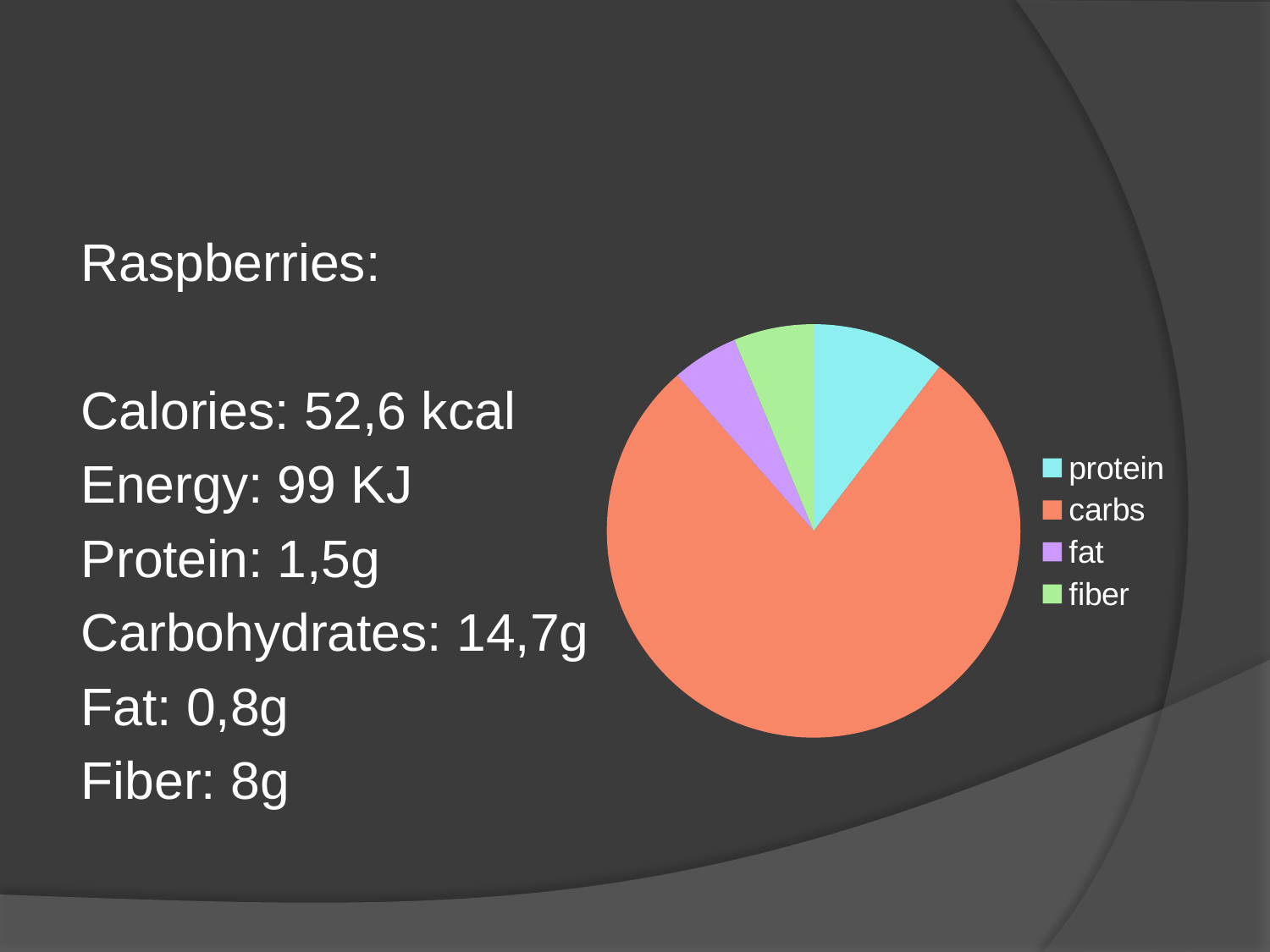
Which category has the largest slice in the pie chart? carbs What colour is the carbs slice in the pie chart? orange How many slices does the pie chart have? 4 Which slice is larger in the pie chart, carbs or protein? carbs Which slice is larger in the pie chart, protein or fat? protein Which slice is larger in the pie chart, protein or fiber? protein Does the carbs slice take up more or less than half of the pie chart? more What kind of chart is shown on the slide? pie chart How many entries does the legend of the pie chart list? 4 Which legend entry is listed first in the pie chart's legend? protein